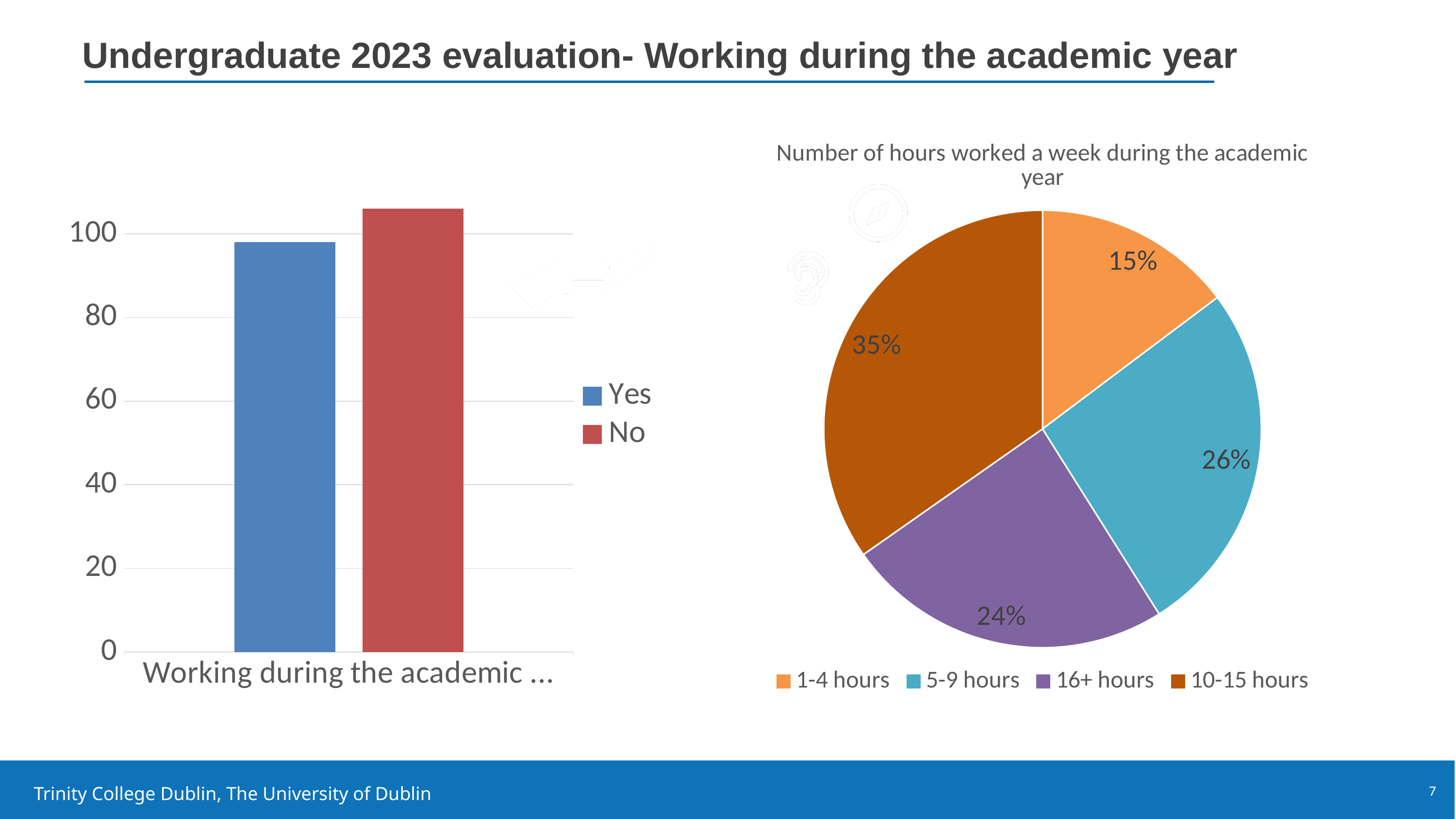
In the pie chart 'Number of hours worked a week during the academic year', what share is 1-4 hours? 15% In the pie chart 'Number of hours worked a week during the academic year', what share is 16+ hours? 24% In the pie chart 'Number of hours worked a week during the academic year', how many categories are shown? 4 In the pie chart 'Number of hours worked a week during the academic year', what share is 5-9 hours? 26% In the pie chart 'Number of hours worked a week during the academic year', which category has the largest share? 10-15 hours In the pie chart 'Number of hours worked a week during the academic year', which category has the smallest share? 1-4 hours In the bar chart on the left, which is larger, Yes or No? No What kind of chart is the chart titled 'Number of hours worked a week during the academic year'? pie chart What kind of chart is the chart on the left of the slide? bar chart In the bar chart on the left, how many series does the legend list? 2 In the bar chart on the left, is the value for Yes greater or less than 100? less In the bar chart on the left, is the value for No greater or less than 100? greater